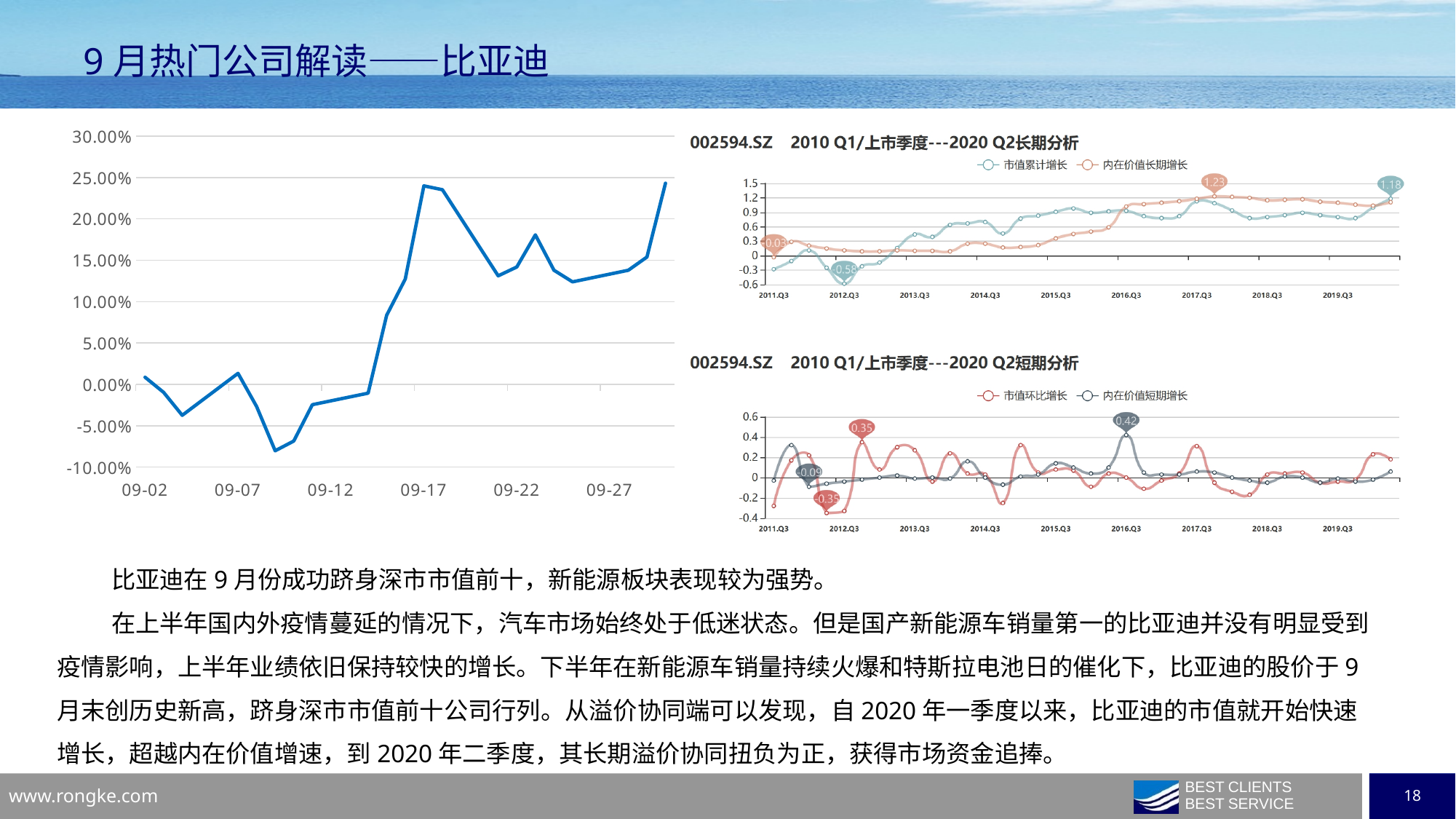
In the left chart, is the value at 09-07 greater or less than 5.00%? less In the chart titled '002594.SZ 2010 Q1/上市季度---2020 Q2短期分析', what is the labeled peak value of 内在价值短期增长 near 2016.Q3? 0.42 In the chart titled '002594.SZ 2010 Q1/上市季度---2020 Q2长期分析', what is the labeled value of 市值累计增长 at the right end of the line? 1.18 In the chart titled '002594.SZ 2010 Q1/上市季度---2020 Q2长期分析', what are the two legend entries? 市值累计增长, 内在价值长期增长 In the chart titled '002594.SZ 2010 Q1/上市季度---2020 Q2长期分析', what is the labeled peak value of 内在价值长期增长 near 2017.Q3? 1.23 In the left chart, is the value at 09-17 greater or less than 20.00%? greater In the left chart, is the lowest point of the line greater or less than -5.00%? less What kind of chart is the chart on the left side of the slide? line chart In the chart titled '002594.SZ 2010 Q1/上市季度---2020 Q2长期分析', what is the labeled lowest value of 市值累计增长 near 2012.Q3? -0.58 How many series does the legend of the chart titled '002594.SZ 2010 Q1/上市季度---2020 Q2长期分析' list? 2 In the chart titled '002594.SZ 2010 Q1/上市季度---2020 Q2短期分析', what is the labeled peak value of 市值环比增长 near 2012.Q3? 0.35